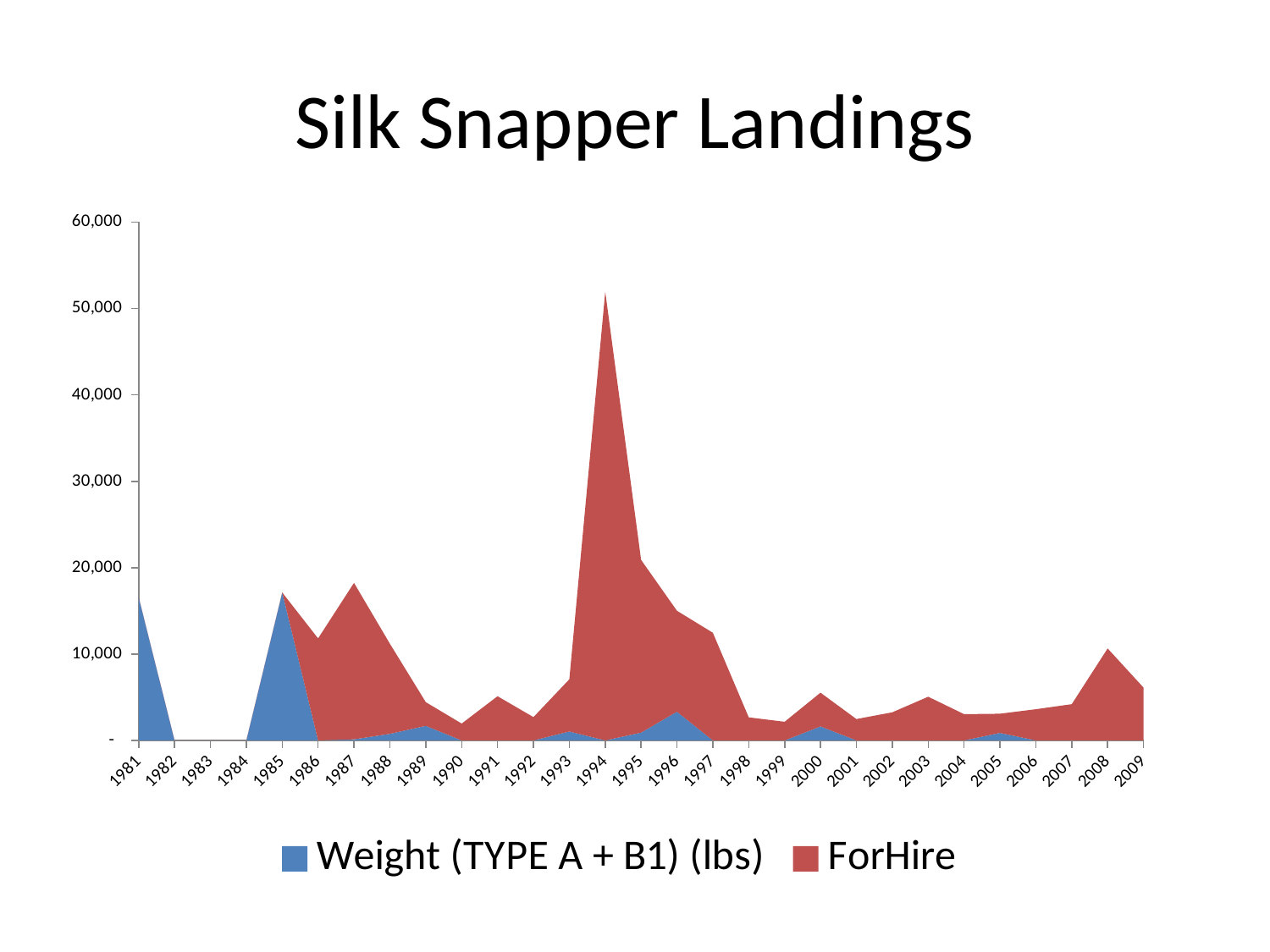
What is the title of the chart? Silk Snapper Landings Which year has the larger total value, 1994 or 1985? 1994 Is the total value for 2008 greater or less than 20,000? less Do the total values rise or fall from 1994 to 1998? fall How many series does the legend list? 2 What type of chart is shown on the slide? Area chart In which year does the chart reach its highest total value? 1994 Is the total value for 1987 greater or less than 10,000? greater How many years are shown along the x axis? 29 Is the total value for 1994 greater or less than 50,000? greater What are the two series named in the legend? Weight (TYPE A + B1) (lbs) and ForHire